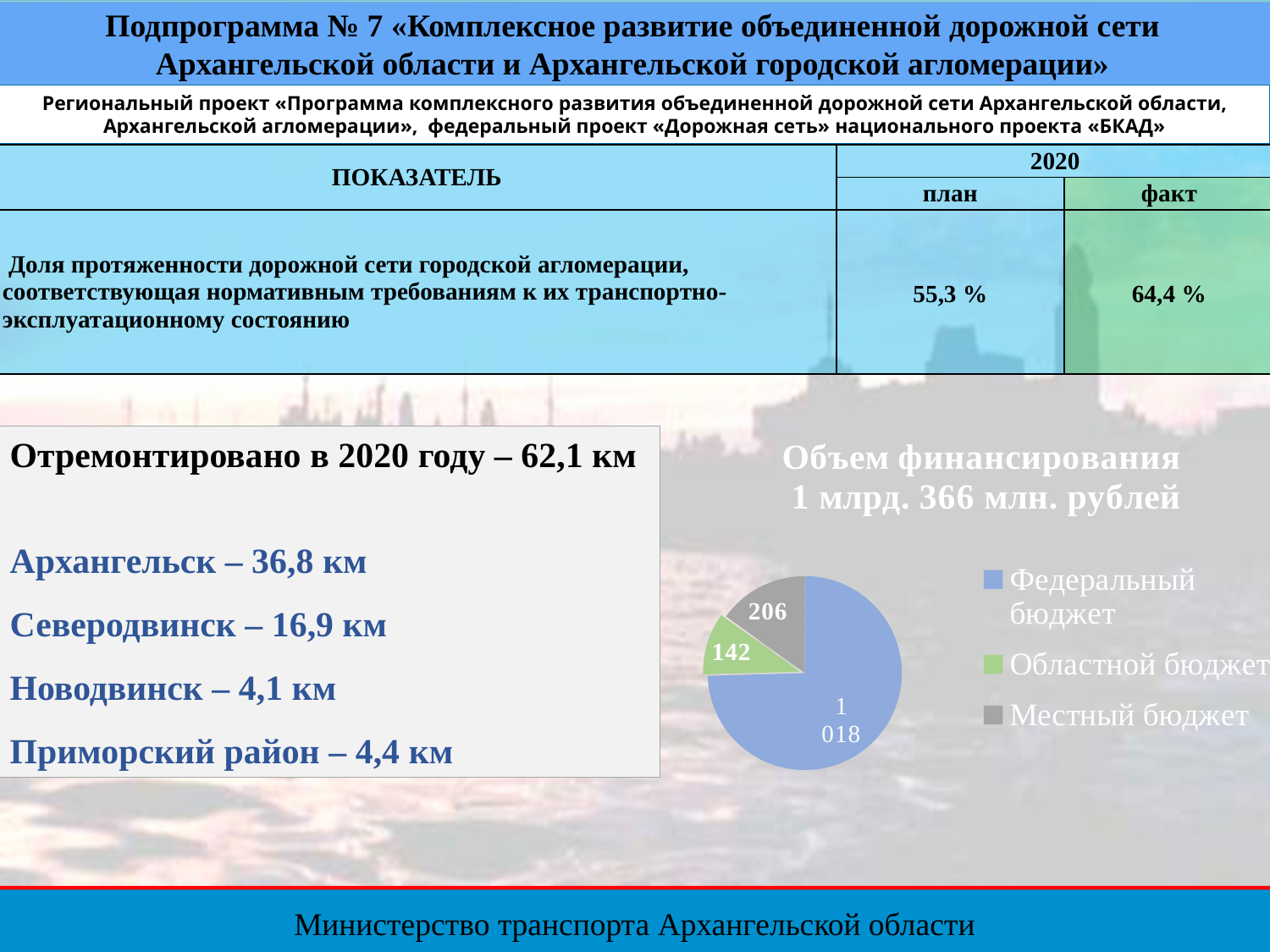
What is the difference between the values for Местный бюджет and Областной бюджет in the pie chart? 64 What colour is the Федеральный бюджет slice in the pie chart? blue What kind of chart is shown on the slide? pie chart What is the value for Федеральный бюджет in the pie chart? 1 018 How many entries does the legend of the pie chart list? 3 Which budget source has the largest slice in the pie chart? Федеральный бюджет Which is larger in the pie chart: Местный бюджет or Областной бюджет? Местный бюджет What is the total of all slices in the pie chart? 1 366 How many slices does the pie chart have? 3 Which budget source has the smallest slice in the pie chart? Областной бюджет What is the value for Местный бюджет in the pie chart? 206 What is the value for Областной бюджет in the pie chart? 142